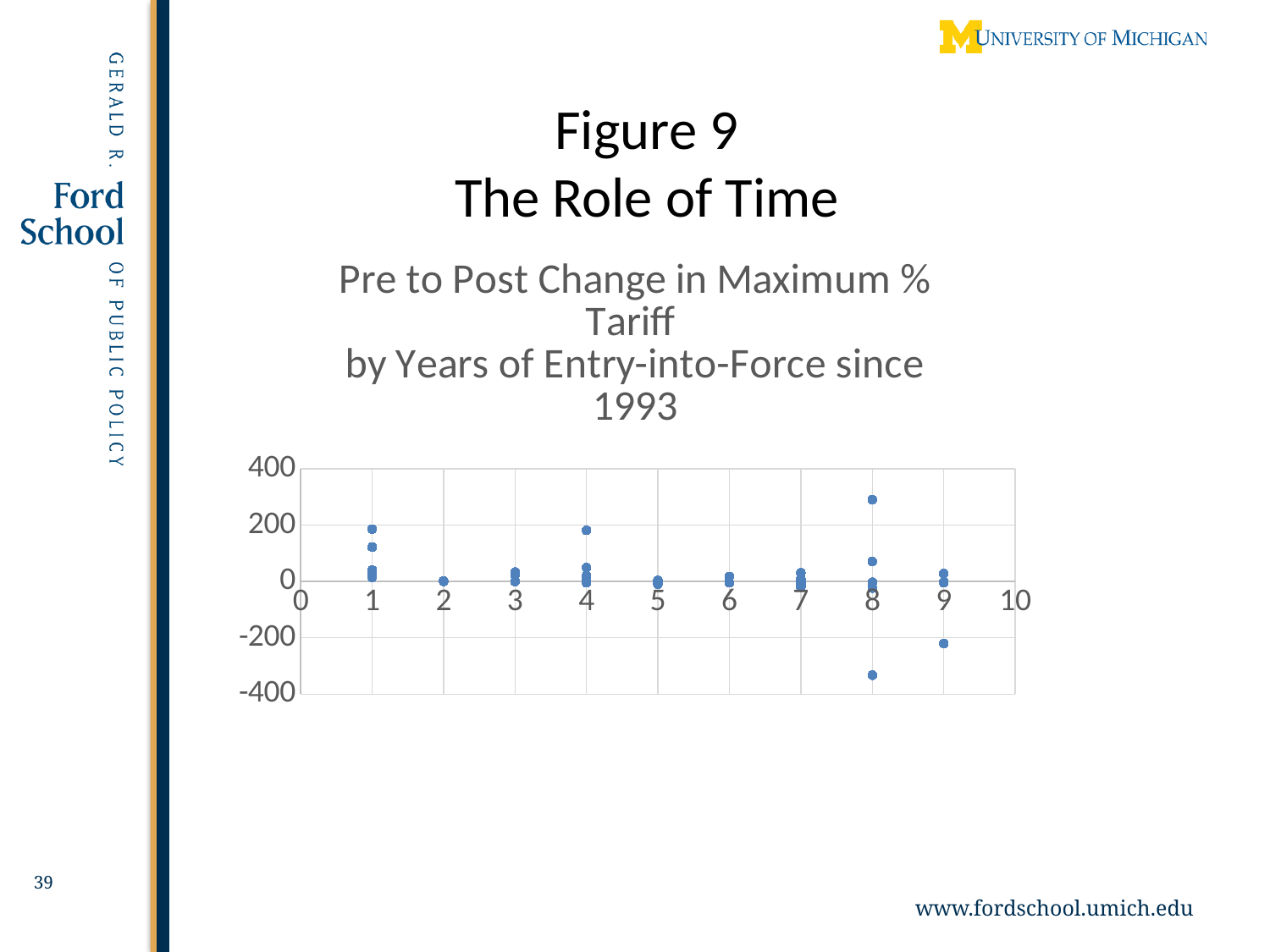
What is the title of the chart on the slide? Pre to Post Change in Maximum % Tariff by Years of Entry-into-Force since 1993 What is the highest tick label shown on the vertical axis of the chart? 400 Is the lowest value plotted at year 8 greater or less than -200? less At which year of entry-into-force does the lowest plotted point occur? 8 How many distinct years of entry-into-force have points plotted on the chart? 9 What kind of chart is shown on the slide? scatter chart Is the highest value plotted at year 8 greater or less than 200? greater Is the lowest value plotted at year 9 greater or less than -100? less At which year of entry-into-force does the highest plotted point occur? 8